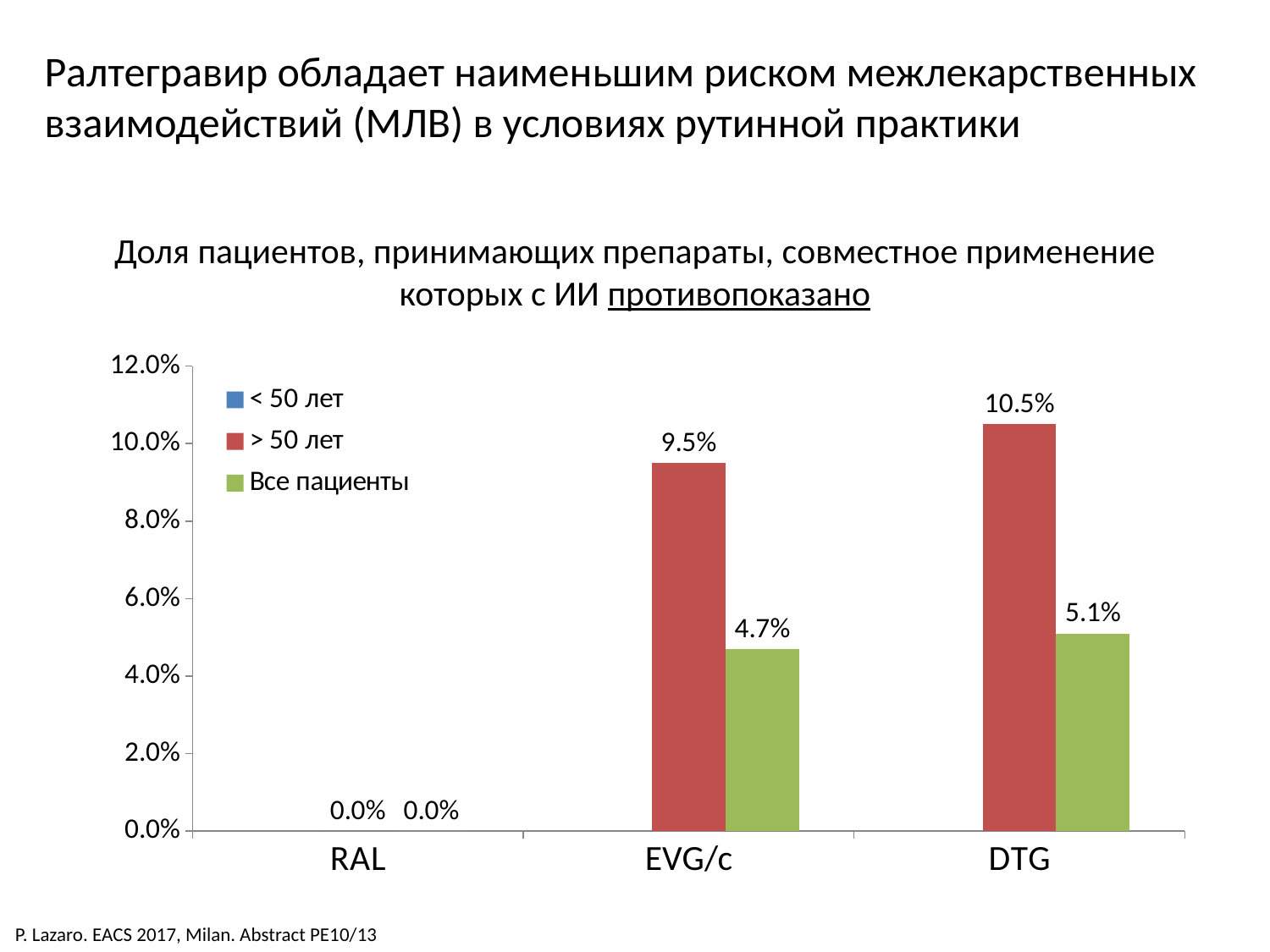
What kind of chart is shown on the slide? Bar chart How many categories are shown on the x axis? 3 For EVG/c, which series has the larger value: "> 50 лет" or "Все пациенты"? > 50 лет What is the value for the "Все пациенты" series for EVG/c? 4.7% How many series does the legend list? 3 What is the difference between the "Все пациенты" values for DTG and EVG/c? 0.4% What is the value for the "> 50 лет" series for DTG? 10.5% What is the difference between the "> 50 лет" values for DTG and EVG/c? 1.0% Which category has the highest value for the "> 50 лет" series? DTG What is the value for the "> 50 лет" series for EVG/c? 9.5% What is the value for the "Все пациенты" series for DTG? 5.1% Which category has the lowest value for the "Все пациенты" series? RAL